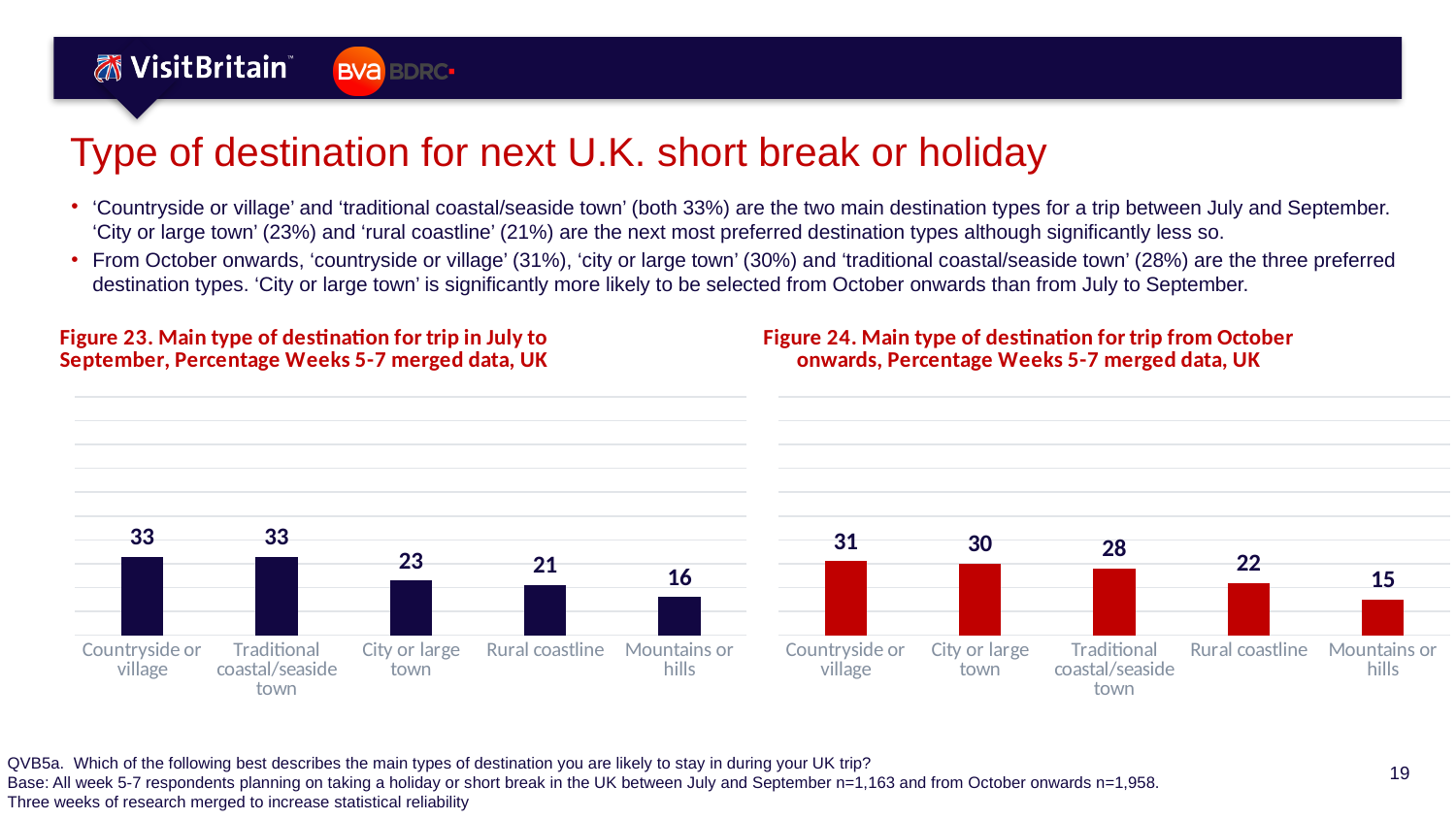
In Figure 23 (July to September), which category has the lowest value? Mountains or hills In Figure 23 (July to September), what is the value for 'Traditional coastal/seaside town'? 33 In Figure 23 (July to September), what is the value for 'City or large town'? 23 In Figure 24 (October onwards), what is the difference between 'City or large town' and 'Mountains or hills'? 15 In Figure 24 (October onwards), what is the value for 'Rural coastline'? 22 In Figure 23 (July to September), what is the difference between 'Countryside or village' and 'Rural coastline'? 12 How many categories are shown in Figure 23 (July to September)? 5 In Figure 24 (October onwards), which category has the highest value? Countryside or village Which is larger: 'City or large town' in Figure 23 (July to September) or 'City or large town' in Figure 24 (October onwards)? Figure 24 (October onwards) In Figure 24 (October onwards), do the values rise or fall from left to right across the categories? Fall What kind of chart is Figure 24 (October onwards)? Bar chart What colour are the bars in Figure 24 (October onwards)? Red